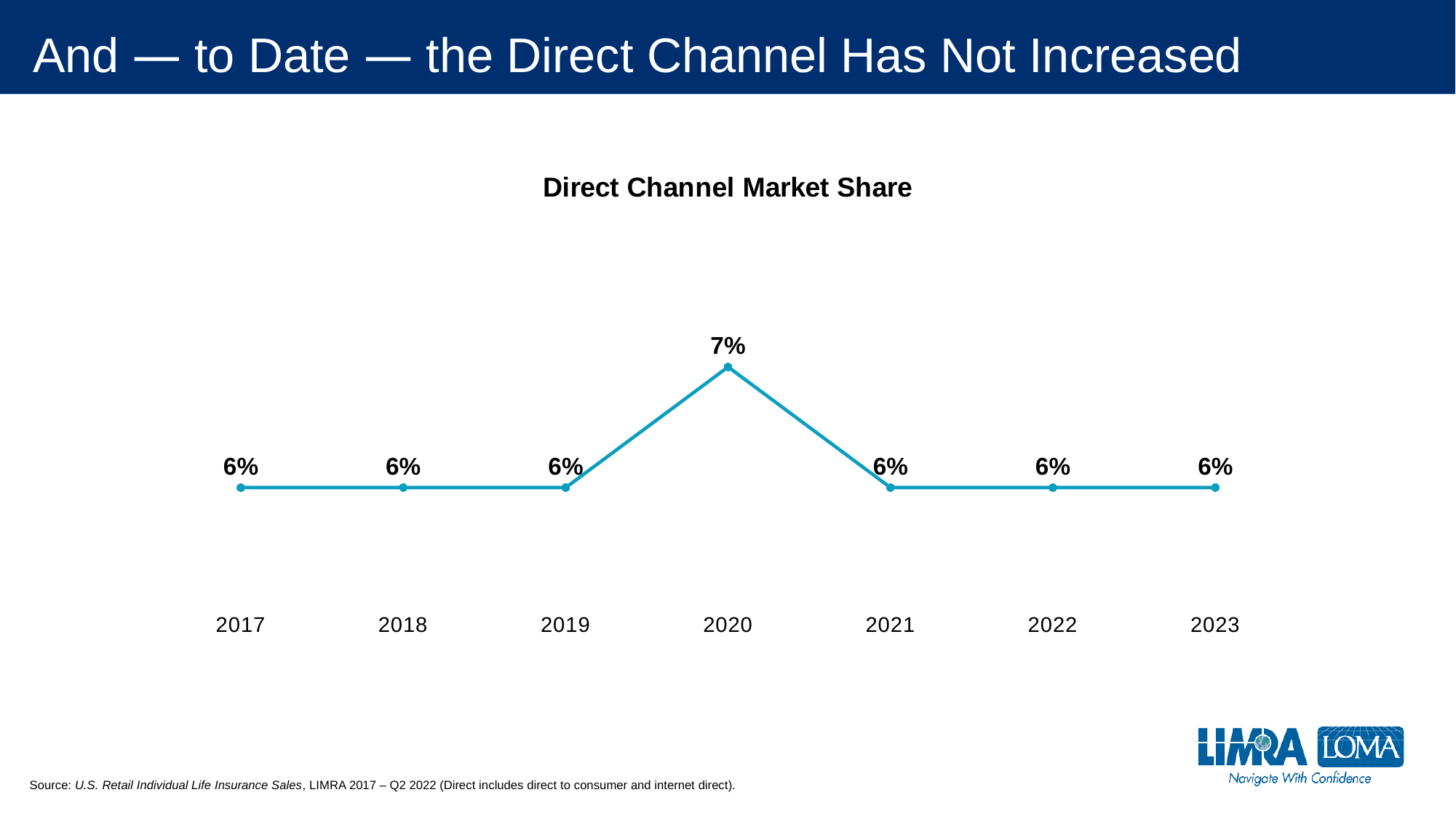
What kind of chart is the Direct Channel Market Share chart? Line chart What is the difference between the Direct Channel Market Share in 2020 and in 2021? 1% Which year has the highest Direct Channel Market Share? 2020 What is the Direct Channel Market Share in 2017? 6% What is the first year shown on the x axis of the chart? 2017 How many years are plotted on the Direct Channel Market Share chart? 7 What is the title of the chart on the slide? Direct Channel Market Share What is the Direct Channel Market Share in 2023? 6% What is the Direct Channel Market Share in 2020? 7% Does the Direct Channel Market Share rise or fall from 2020 to 2021? Fall Does the Direct Channel Market Share change between 2021 and 2023? No, it stays at 6% Which is larger, the Direct Channel Market Share in 2020 or in 2019? 2020